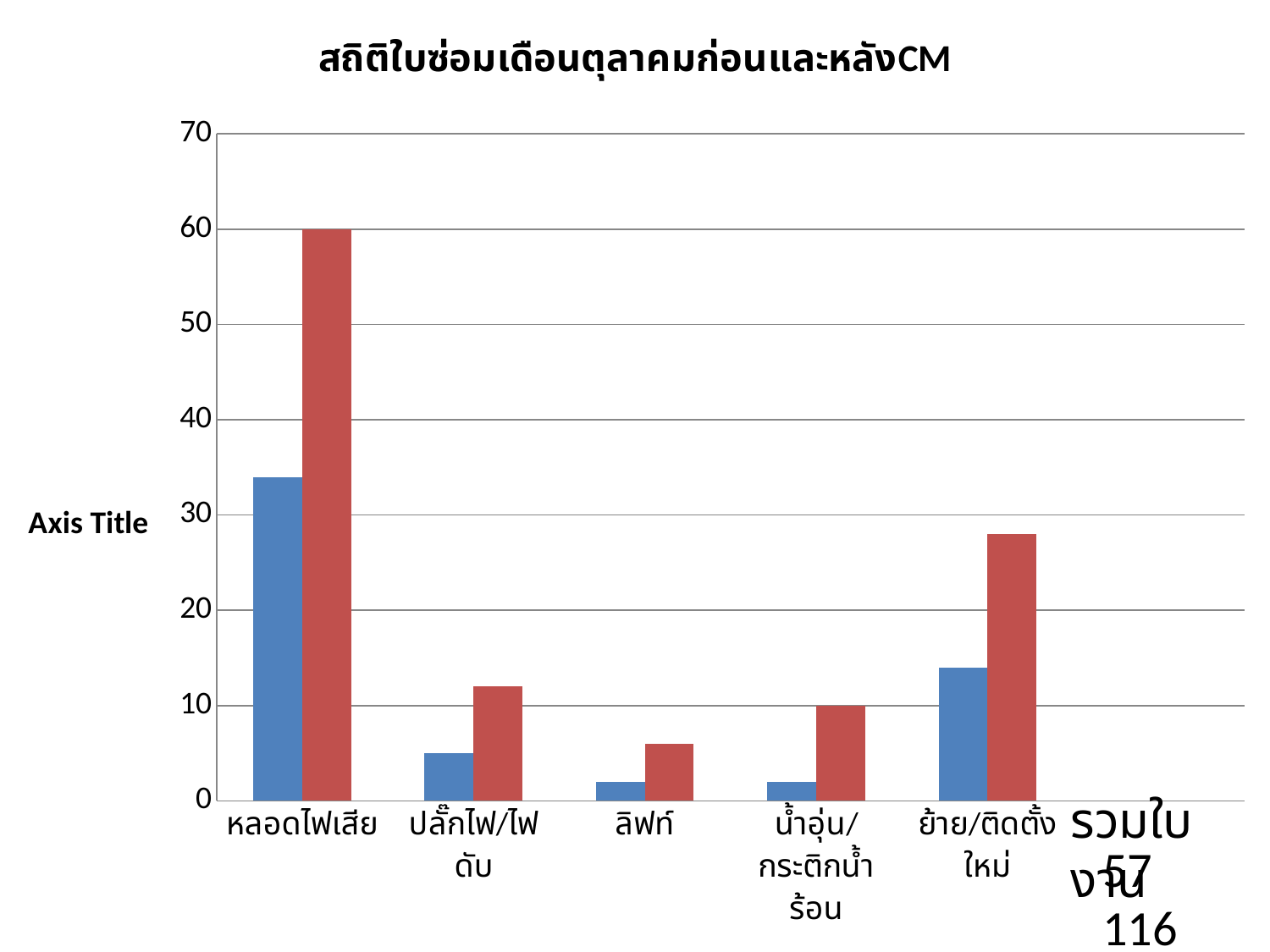
Which is larger for ย้าย/ติดตั้งใหม่, the blue bar or the red bar? the red bar Which category has the highest red bar? หลอดไฟเสีย Is the blue bar for ปลั๊กไฟ/ไฟดับ greater or less than 10? less Is the blue bar for หลอดไฟเสีย greater or less than 30? greater Which category has the highest blue bar? หลอดไฟเสีย What is the value of the red bar for หลอดไฟเสีย? 60 What is the title of the chart? สถิติใบซ่อมเดือนตุลาคมก่อนและหลังCM What is the value of the red bar for น้ำอุ่น/กระติกน้ำร้อน? 10 How many categories are shown on the x axis of the chart? 5 What kind of chart is shown on the slide? bar chart What is the label shown on the vertical axis of the chart? Axis Title Is the red bar for ย้าย/ติดตั้งใหม่ greater or less than 30? less